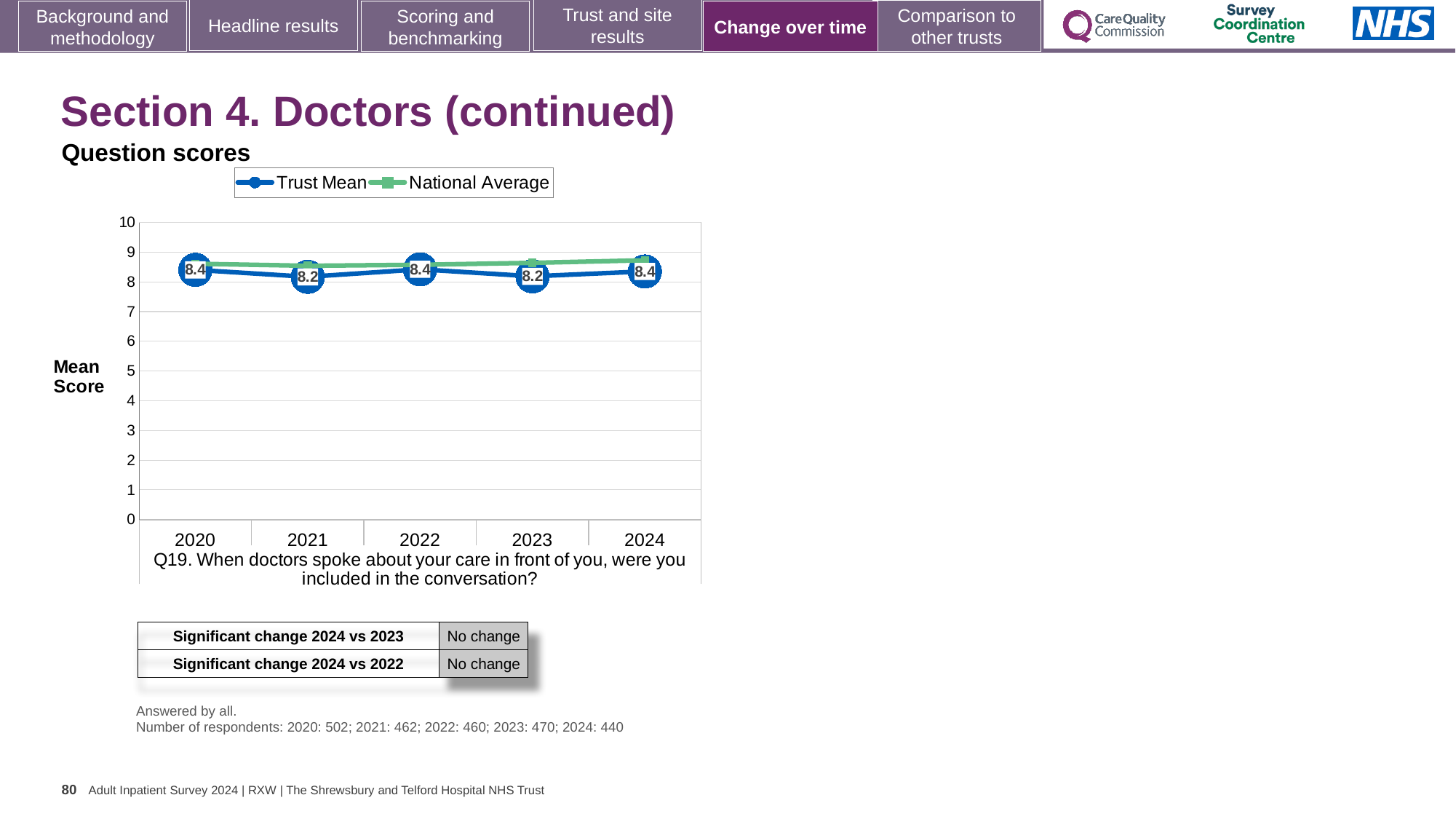
Which series is shown in green in the legend? National Average What is the Trust Mean score for 2020? 8.4 What is the difference between the Trust Mean scores for 2022 and 2023? 0.2 How many years are shown on the x axis? 5 What is the Trust Mean score for 2023? 8.2 What is the Trust Mean score for 2021? 8.2 What is the label on the y axis? Mean Score How many series does the legend list? 2 What kind of chart is shown? line chart What is the Trust Mean score for 2024? 8.4 Is the National Average value for 2024 greater or less than 8? greater Which is larger, the Trust Mean score for 2021 or for 2022? 2022